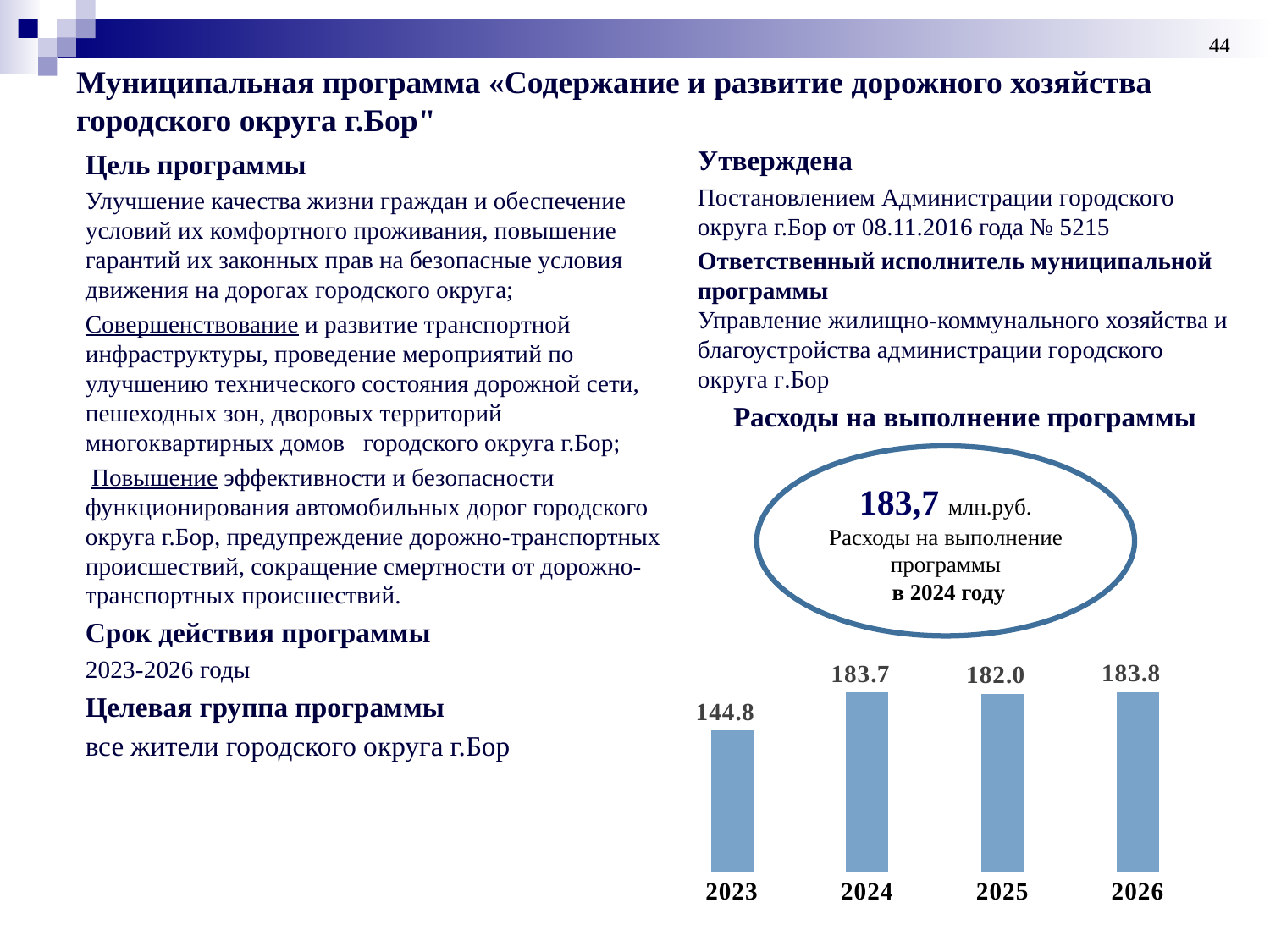
How many years are shown on the x axis of the chart? 4 What is the title of the chart? Расходы на выполнение программы What is the value for 2025 in the chart? 182.0 What kind of chart is shown on the slide? bar chart What is the value for 2026 in the chart? 183.8 What is the difference between the values for 2024 and 2023? 38.9 Which is larger, the value for 2023 or the value for 2025? 2025 Which year has the lowest value in the chart? 2023 What is the difference between the values for 2024 and 2025? 1.7 What is the value for 2024 in the chart? 183.7 Does the value rise or fall from 2023 to 2024? rise What is the value for 2023 in the chart? 144.8